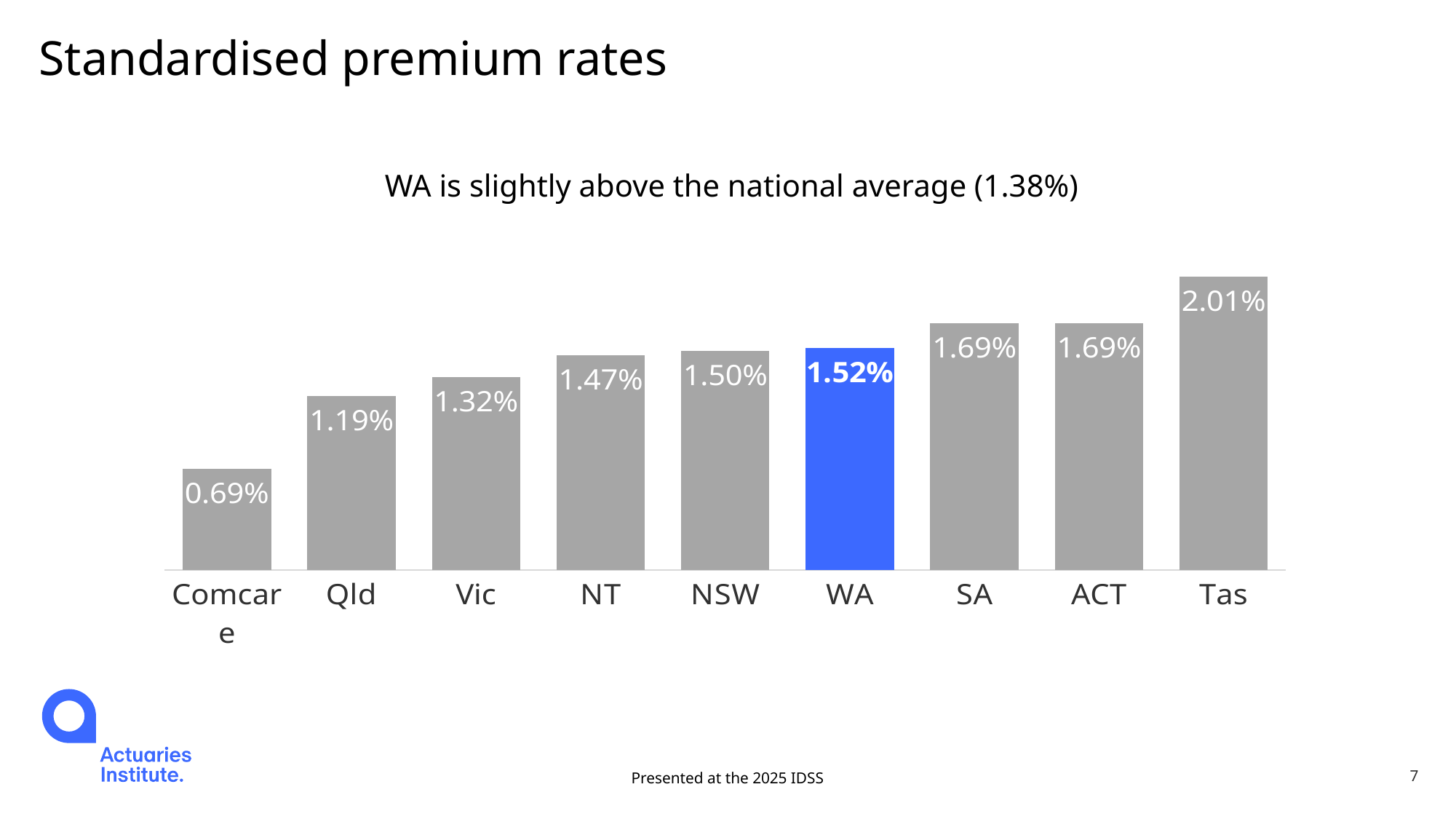
Which category has the lowest standardised premium rate? Comcare What is the difference between the premium rates for Qld and Comcare? 0.50% How many categories are shown in the chart? 9 What is the standardised premium rate for NSW? 1.50% What is the standardised premium rate for WA? 1.52% What kind of chart is shown on the slide? Bar chart Which bar is highlighted in blue? WA Which category has the highest standardised premium rate? Tas What is the standardised premium rate for Comcare? 0.69% Do the values rise or fall from left to right across the chart? Rise What is the difference between the premium rates for Tas and WA? 0.49% Which has a higher standardised premium rate, Vic or NT? NT